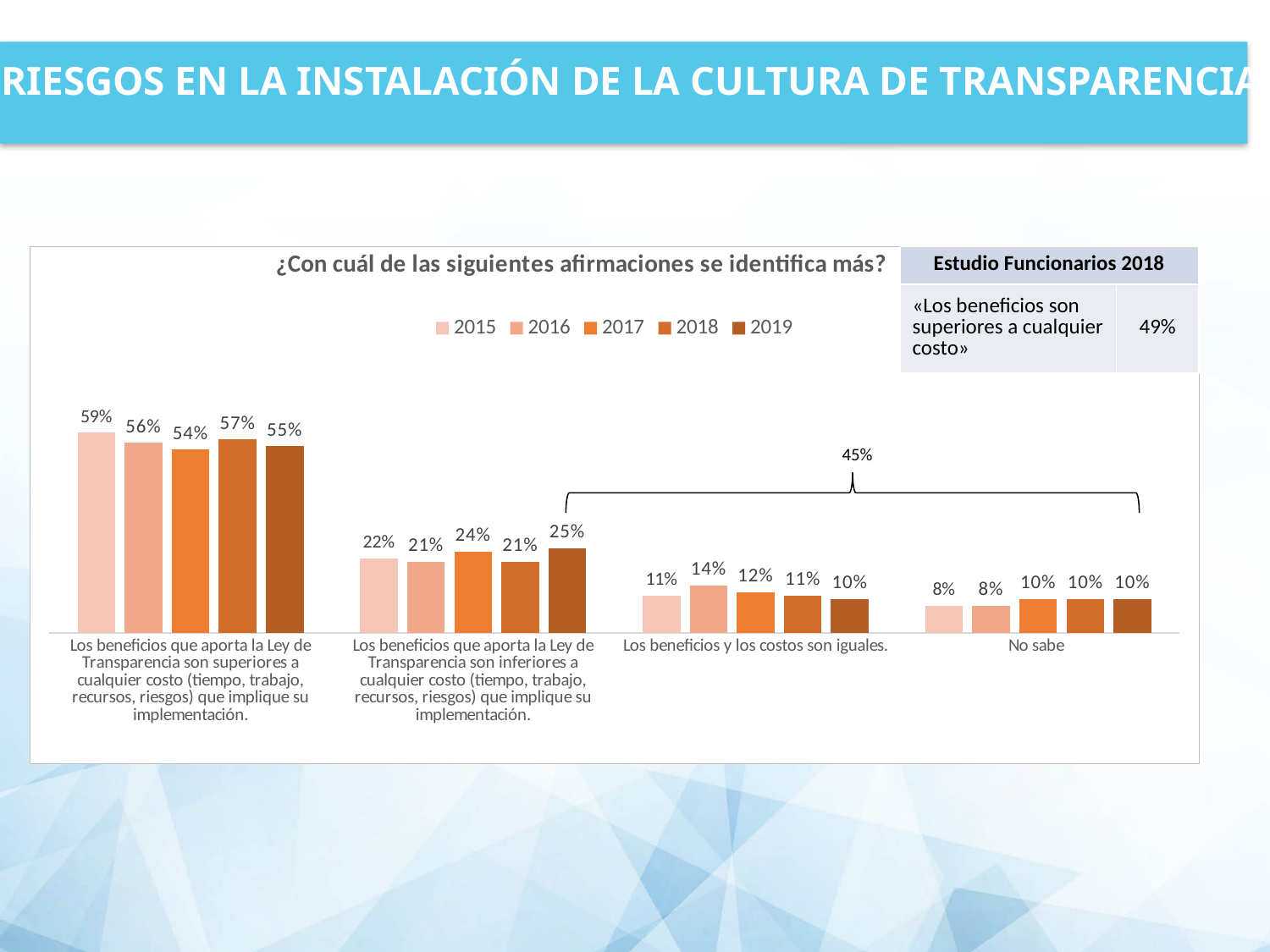
What is the difference between the 2015 and 2019 values for "Los beneficios que aporta la Ley de Transparencia son superiores a cualquier costo"? 4% How many series does the legend list? 5 How many categories are shown on the x axis? 4 What type of chart is shown on the slide? bar chart What is the 2019 value for "Los beneficios que aporta la Ley de Transparencia son inferiores a cualquier costo"? 25% What is the 2016 value for "Los beneficios y los costos son iguales"? 14% Which is larger: the 2017 value for "Los beneficios y los costos son iguales" or the 2017 value for "No sabe"? Los beneficios y los costos son iguales Which year has the highest value for "Los beneficios que aporta la Ley de Transparencia son superiores a cualquier costo"? 2015 What is the 2015 value for "No sabe"? 8% Which year has the lowest value for "Los beneficios que aporta la Ley de Transparencia son superiores a cualquier costo"? 2017 What is the 2015 value for "Los beneficios que aporta la Ley de Transparencia son superiores a cualquier costo"? 59% What is the title of the chart? ¿Con cuál de las siguientes afirmaciones se identifica más?